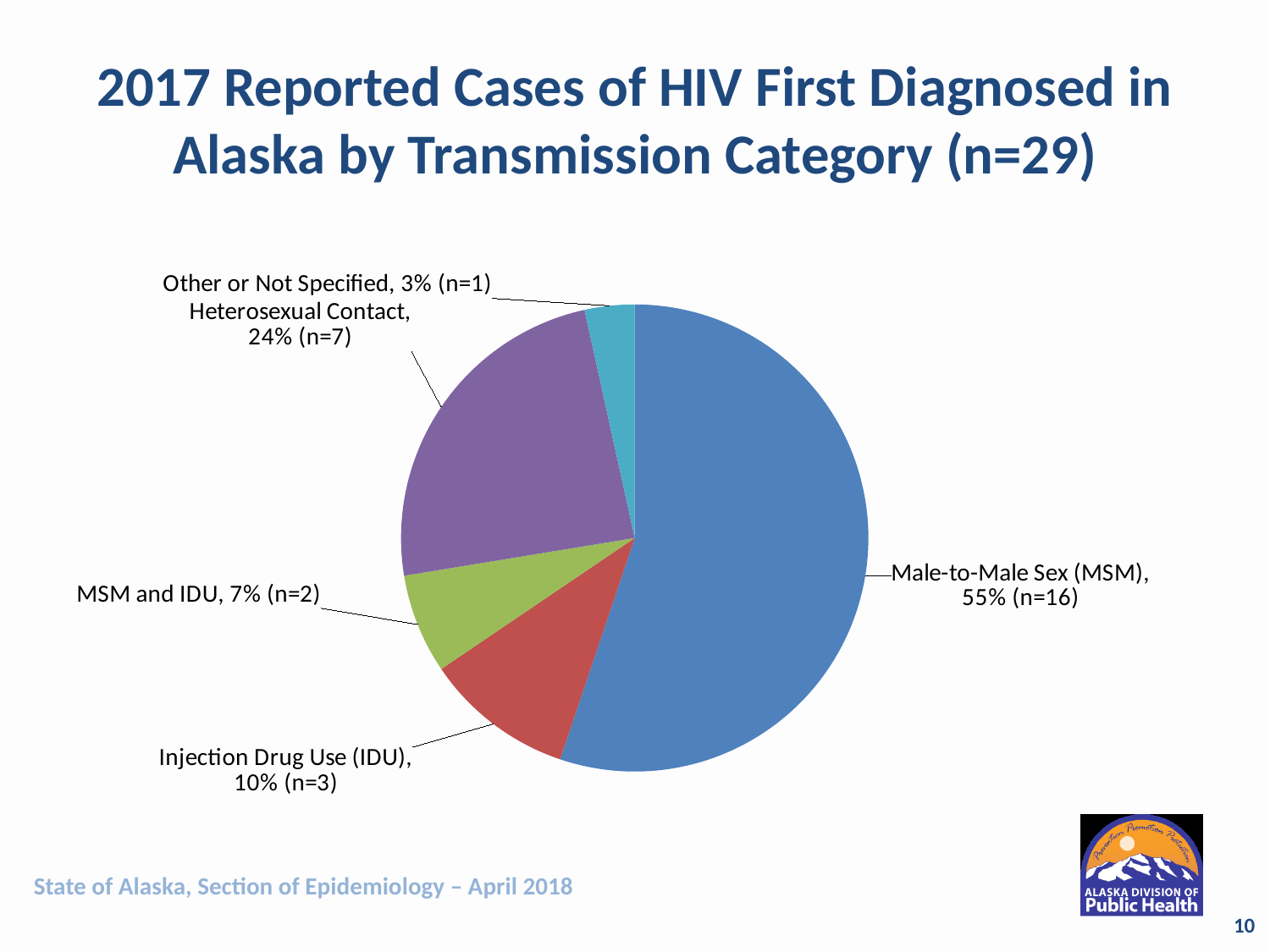
How many cases (n) are attributed to Heterosexual Contact? 7 How many transmission categories are shown in the pie chart? 5 How many cases (n) are in the MSM and IDU category? 2 What percentage of cases is attributed to Male-to-Male Sex (MSM)? 55% Which transmission category has the largest share of cases? Male-to-Male Sex (MSM) What is the difference in number of cases between Male-to-Male Sex (MSM) and Heterosexual Contact? 9 Which has a larger share of cases, Injection Drug Use (IDU) or MSM and IDU? Injection Drug Use (IDU) What is the total number of cases (n) given in the chart title? 29 What percentage of cases is attributed to Injection Drug Use (IDU)? 10% What kind of chart is shown on the slide? pie chart What is the share of the pie for Other or Not Specified? 3% Which transmission category has the smallest share of cases? Other or Not Specified